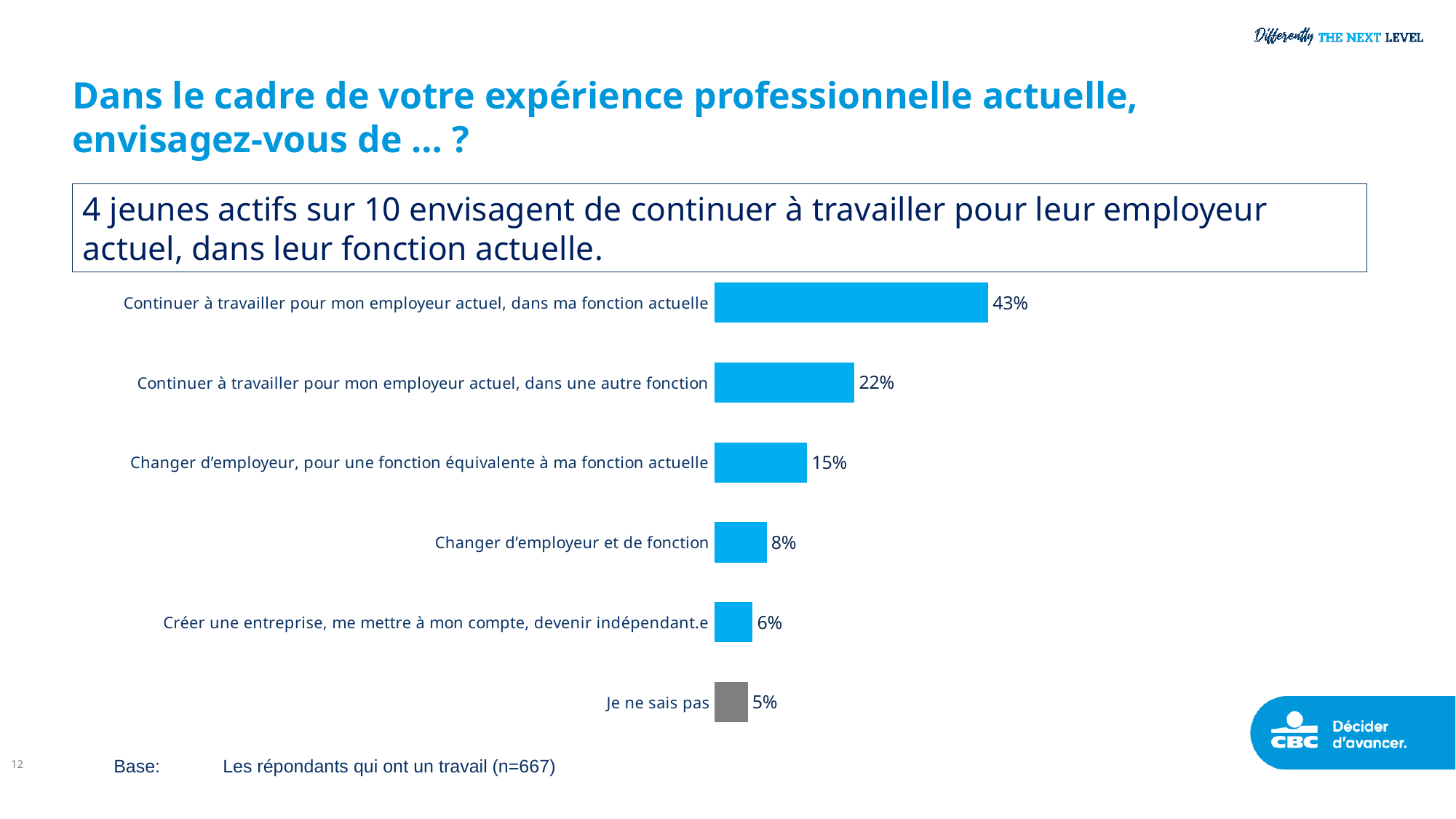
What is the value for "Changer d'employeur, pour une fonction équivalente à ma fonction actuelle"? 15% What is the base (number of respondents) stated below the chart? n=667 Which category has the highest value? Continuer à travailler pour mon employeur actuel, dans ma fonction actuelle Which category has the lowest value? Je ne sais pas What is the value for "Continuer à travailler pour mon employeur actuel, dans une autre fonction"? 22% What kind of chart is shown on the slide? Bar chart Which bar is shown in grey rather than blue? Je ne sais pas What percentage of respondents plan to continue working for their current employer in their current role ("Continuer à travailler pour mon employeur actuel, dans ma fonction actuelle")? 43% What is the difference between "Continuer à travailler pour mon employeur actuel, dans ma fonction actuelle" and "Continuer à travailler pour mon employeur actuel, dans une autre fonction"? 21 percentage points Which is larger: "Changer d'employeur et de fonction" or "Créer une entreprise, me mettre à mon compte, devenir indépendant.e"? Changer d'employeur et de fonction What is the value for "Je ne sais pas"? 5% How many categories are shown in the chart? 6